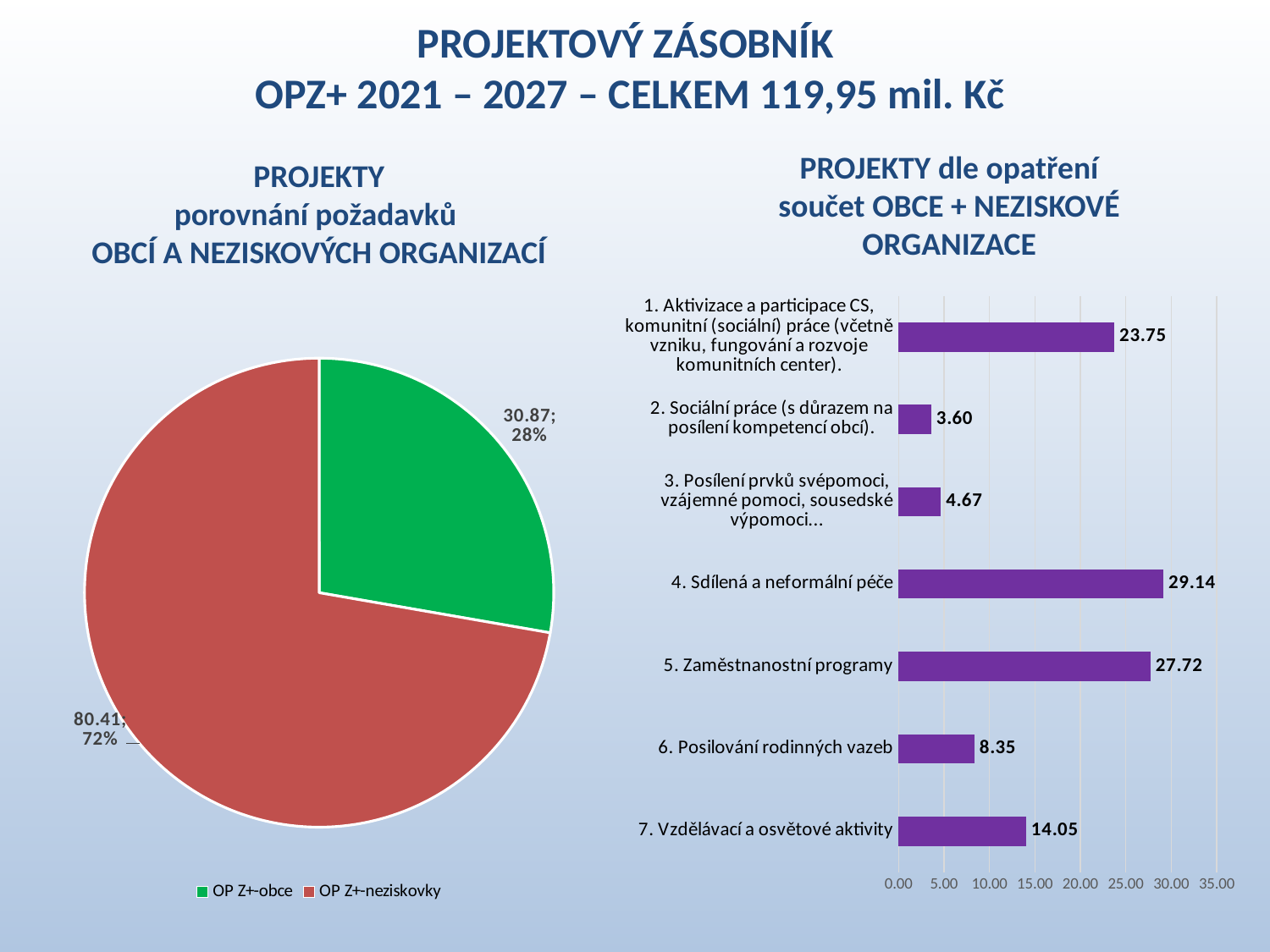
What type of chart is the chart 'PROJEKTY dle opatření' on the right? Bar chart In the pie chart on the left, what value is shown for OP Z+-obce? 30.87 In the pie chart on the left, what colour is the OP Z+-obce slice? Green In the chart 'PROJEKTY dle opatření', which category has the lowest value? 2. Sociální práce (s důrazem na posílení kompetencí obcí). How many categories are shown in the chart 'PROJEKTY dle opatření'? 7 In the chart 'PROJEKTY dle opatření', what is the difference between the values for '5. Zaměstnanostní programy' and '7. Vzdělávací a osvětové aktivity'? 13.67 In the chart 'PROJEKTY dle opatření', what is the value for '4. Sdílená a neformální péče'? 29.14 In the chart 'PROJEKTY dle opatření', which category has the highest value? 4. Sdílená a neformální péče In the pie chart on the left, which slice is larger, OP Z+-obce or OP Z+-neziskovky? OP Z+-neziskovky In the chart 'PROJEKTY dle opatření', what is the value for '6. Posilování rodinných vazeb'? 8.35 How many entries does the legend of the pie chart on the left list? 2 In the pie chart on the left, what share of the pie does OP Z+-neziskovky take? 72%